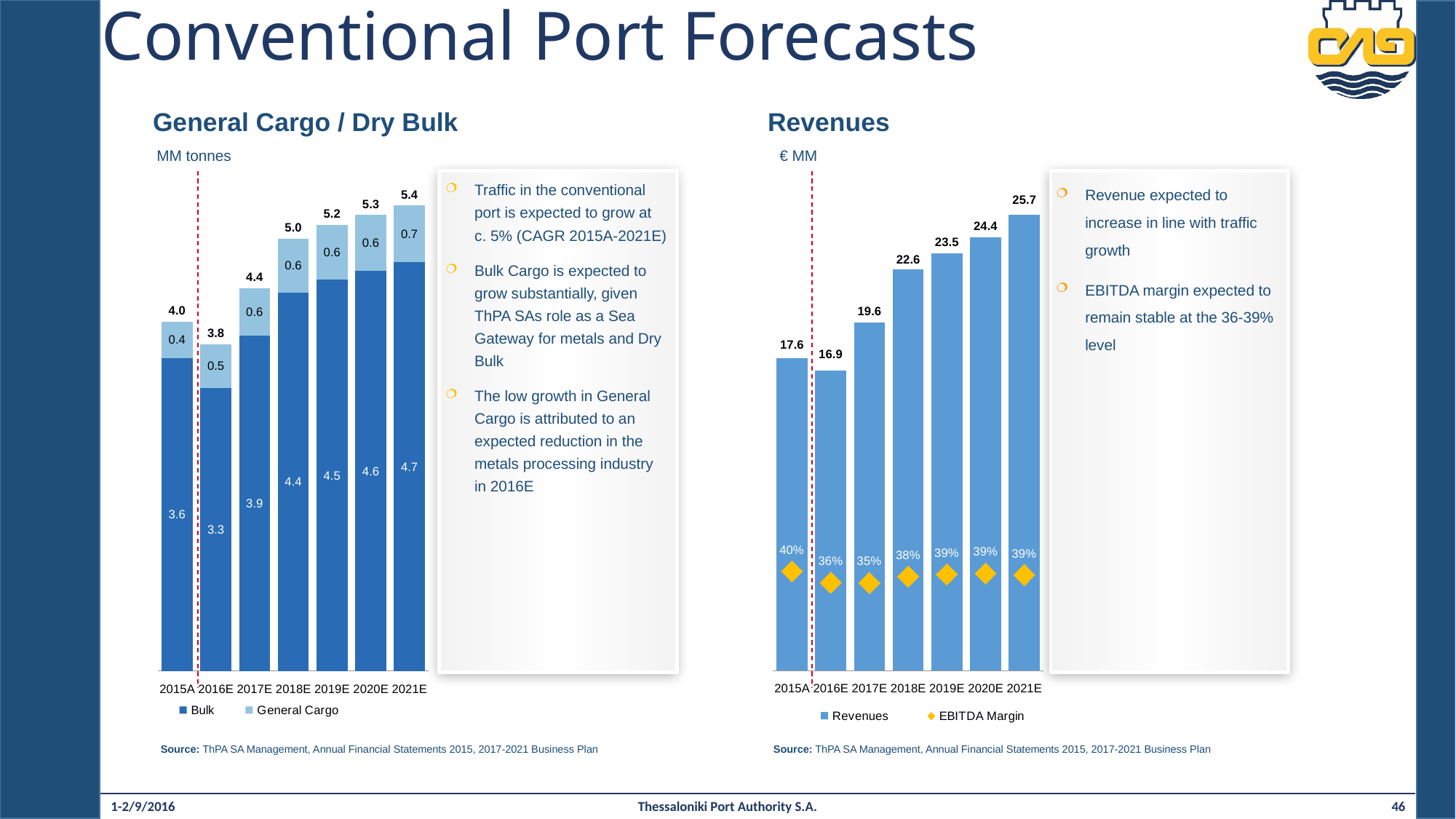
In the General Cargo / Dry Bulk chart, which year has the lowest total? 2016E In the General Cargo / Dry Bulk chart, what is the difference between the Bulk values for 2021E and 2015A? 1.1 In the General Cargo / Dry Bulk chart, what is the General Cargo value for 2016E? 0.5 In the Revenues chart, what is the difference between the Revenues values for 2021E and 2020E? 1.3 In the General Cargo / Dry Bulk chart, what is the Bulk value for 2018E? 4.4 In the Revenues chart, what is the EBITDA Margin for 2017E? 35% In the Revenues chart, is the Revenues value for 2016E larger or smaller than for 2015A? smaller In the Revenues chart, which year has the highest Revenues value? 2021E In the Revenues chart, what is the Revenues value for 2019E? 23.5 In the General Cargo / Dry Bulk chart, what is the total of the stacked bar for 2021E? 5.4 How many series does the legend of the General Cargo / Dry Bulk chart list? 2 How many years are shown on the x axis of the Revenues chart? 7